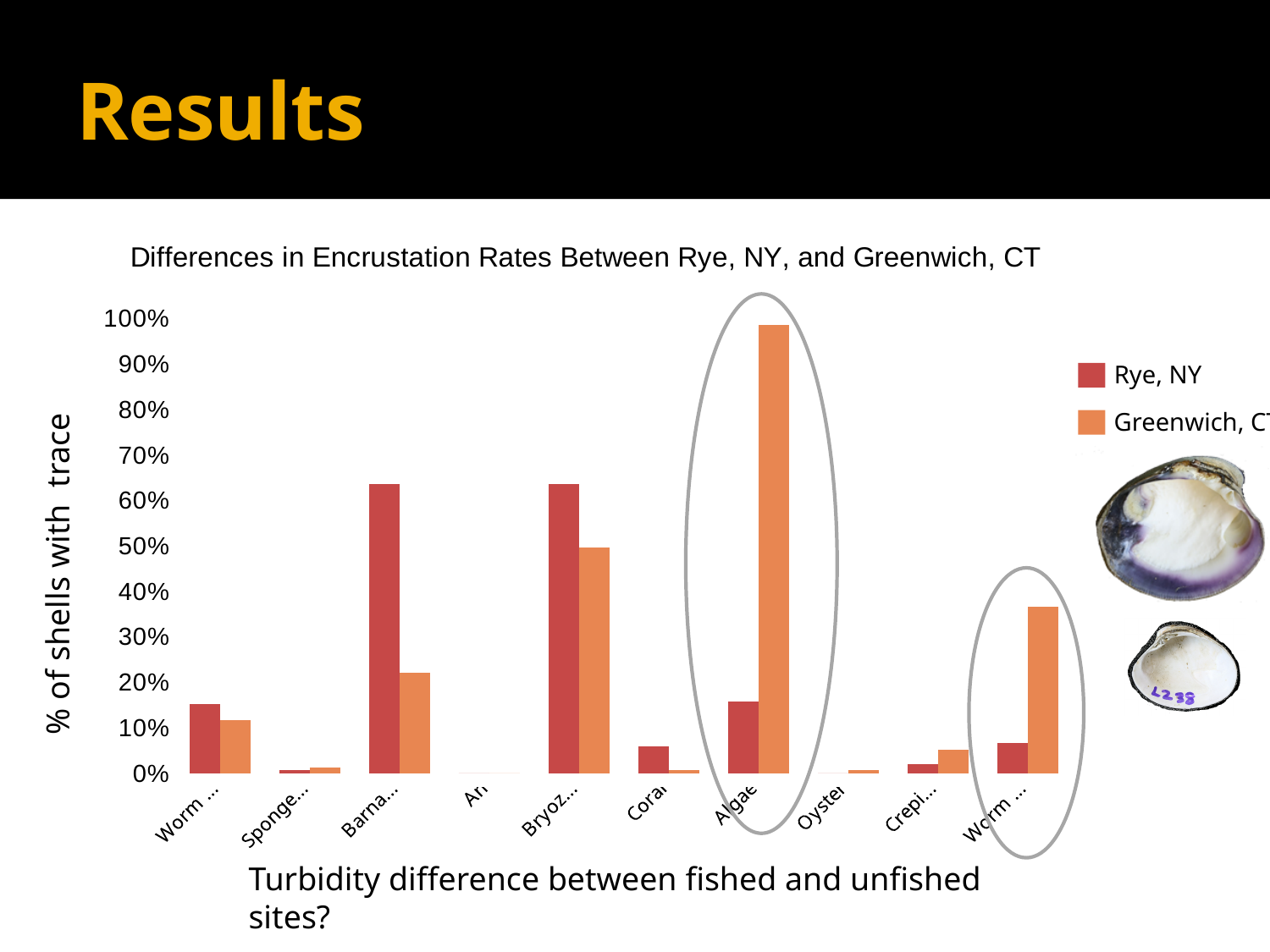
Is the Rye, NY value for Algae greater or less than 20%? less How many categories are shown along the x axis of the chart? 10 Is the Rye, NY value for Algae greater or less than 10%? greater Which category has the highest bar in the chart? Algae What is the title of the chart? Differences in Encrustation Rates Between Rye, NY, and Greenwich, CT What type of chart is shown on the slide? Bar chart How many series does the chart's legend list? 2 For the Greenwich, CT series, which category has the highest value? Algae For Algae, which series has the larger value, Rye, NY or Greenwich, CT? Greenwich, CT What is the label of the y axis of the chart? % of shells with trace Is the Greenwich, CT value for Algae greater or less than 90%? greater